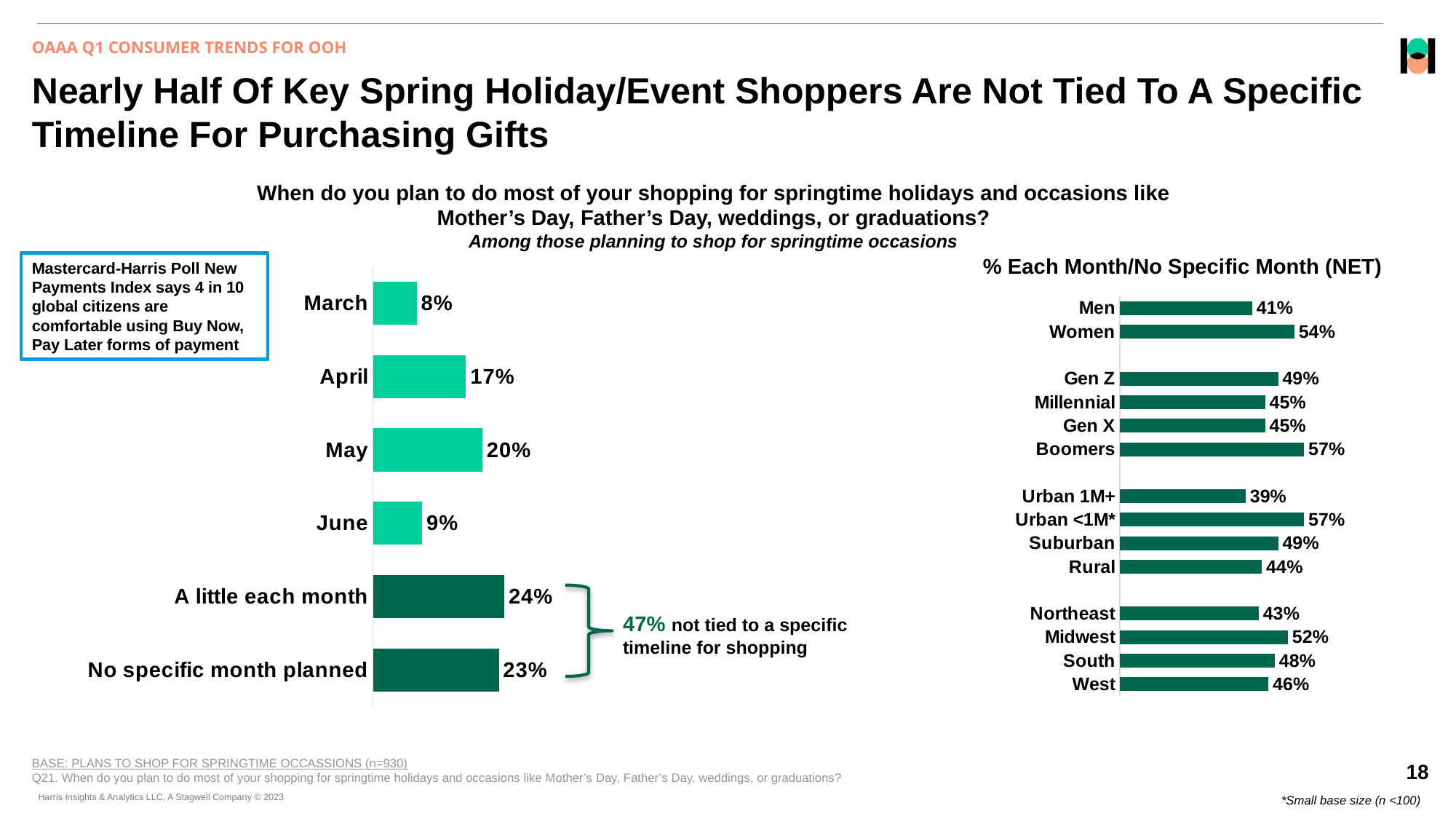
In the left chart on shopping timing, how many categories are shown? 6 In the left chart on shopping timing, what is the difference between the April and June values? 8% In the '% Each Month/No Specific Month (NET)' chart, what is the difference between Boomers and Millennial? 12% What type of chart is the left chart on shopping timing? Bar chart In the '% Each Month/No Specific Month (NET)' chart, how many categories are shown? 14 In the '% Each Month/No Specific Month (NET)' chart, what is the value for Women? 54% In the left chart on shopping timing, what percentage chose 'A little each month'? 24% In the '% Each Month/No Specific Month (NET)' chart, which category has the lowest value? Urban 1M+ In the left chart on shopping timing, which category has the lowest value? March In the left chart on shopping timing, what percentage plan to do most of their shopping in May? 20% In the left chart on shopping timing, which category has the highest value? A little each month In the '% Each Month/No Specific Month (NET)' chart, which is larger, Midwest or Northeast? Midwest